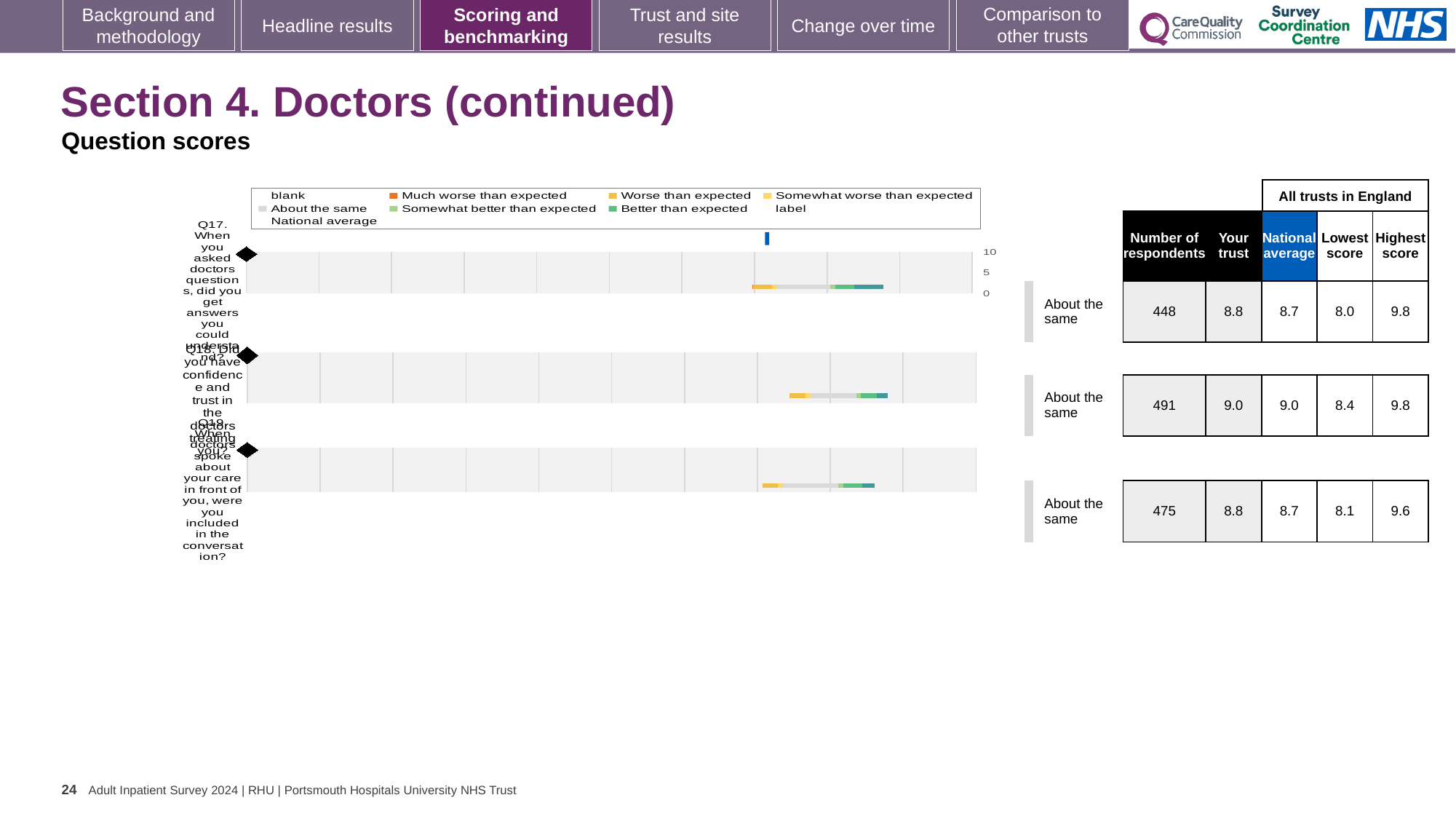
How many questions (categories) are plotted in the chart? 3 Which question has the largest number of respondents in the table beside the chart? Q18 What is the title of the section shown above the chart? Section 4. Doctors (continued) According to the table beside the chart, what is the highest score for Q19? 9.6 What kind of chart is used to show the question scores on this slide? bar chart According to the table beside the chart, what is the national average for Q18? 9.0 What benchmark category is shown next to each of the three questions in the chart? About the same Which question has the lowest 'Lowest score' in the table beside the chart? Q17 According to the table beside the chart, how many respondents answered Q19? 475 According to the table beside the chart, what is the 'Your trust' score for Q17? 8.8 What is the difference between the highest score and the lowest score for Q17 in the table beside the chart? 1.8 Is the 'Your trust' score for Q18 larger or smaller than the 'Your trust' score for Q17? larger